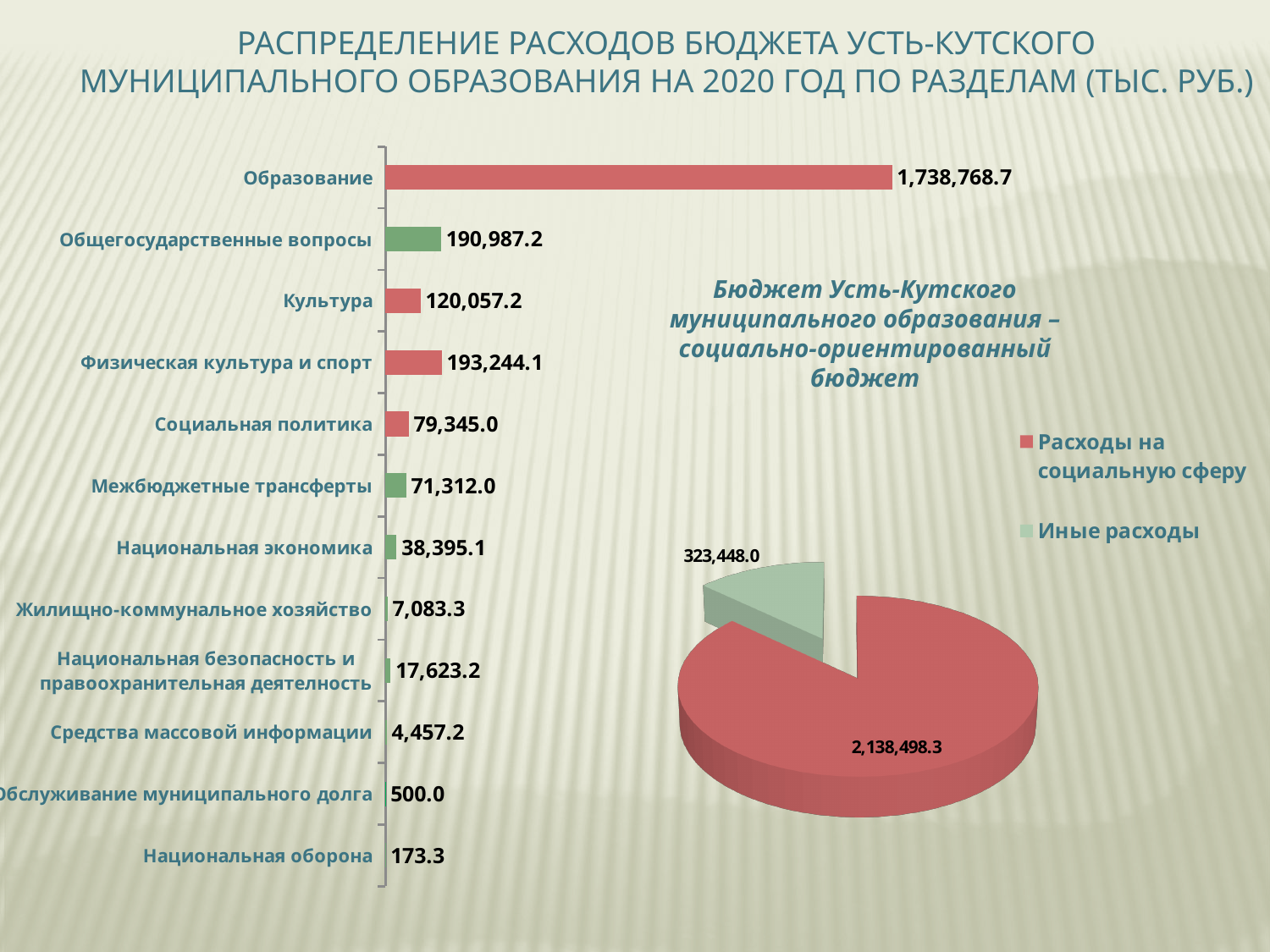
In the bar chart on the left, what is the value for Национальная оборона? 173.3 How many categories does the bar chart on the left show? 12 In the bar chart on the left, which category has the lowest value? Национальная оборона In the bar chart on the left, what is the difference between Физическая культура и спорт and Культура? 73,186.9 What kind of chart is the chart on the left of the slide? Bar chart In the bar chart on the left, what is the value for Физическая культура и спорт? 193,244.1 In the bar chart on the left, which category has the highest value? Образование In the bar chart on the left, which is larger: Социальная политика or Межбюджетные трансферты? Социальная политика In the pie chart on the right, what is the total of the two slices? 2,461,946.3 How many entries does the legend of the pie chart on the right list? 2 In the pie chart on the right, what is the value of the Иные расходы slice? 323,448.0 In the bar chart on the left, what is the value for Образование? 1,738,768.7